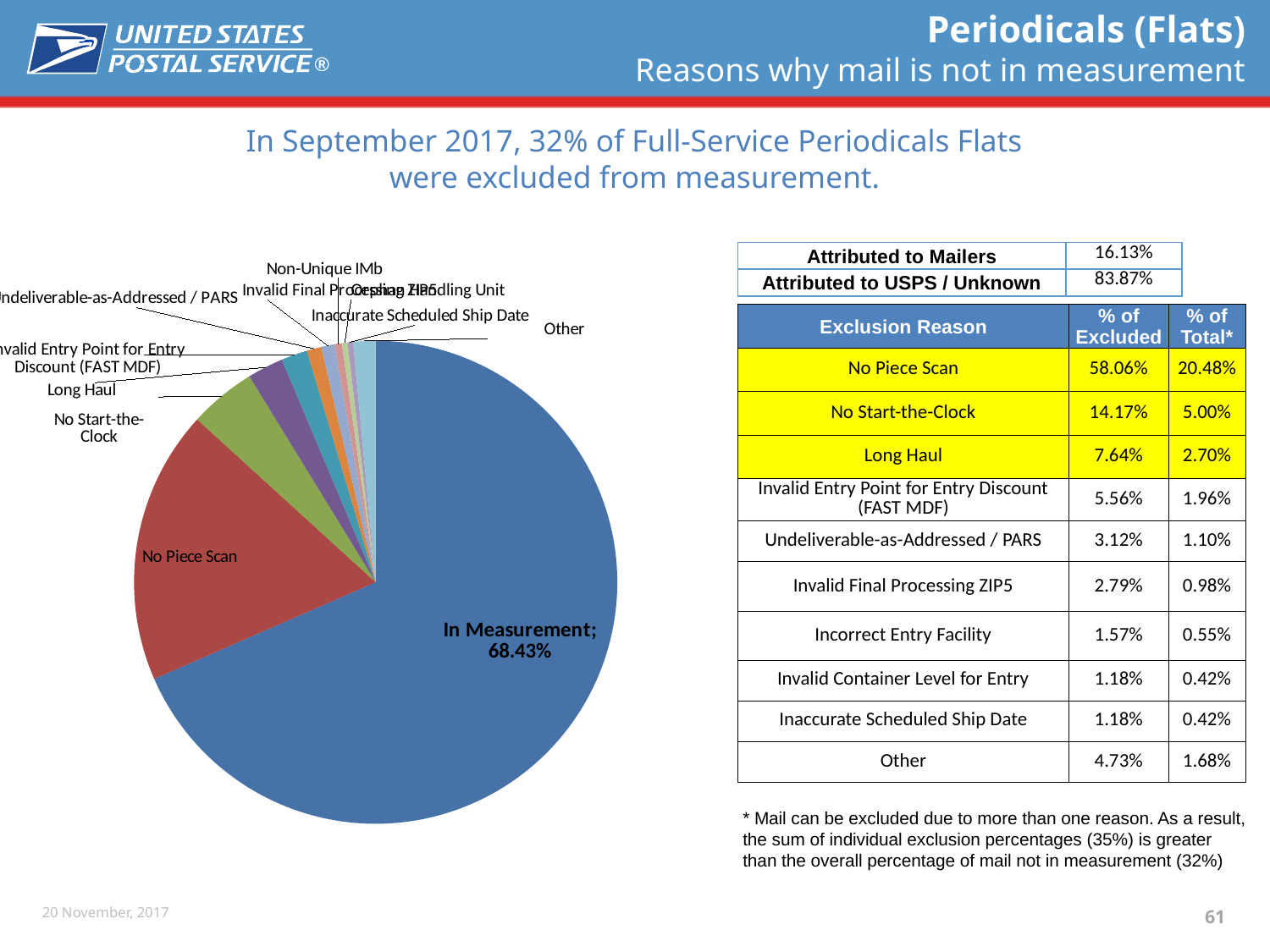
Is the value for In Measurement greater or less than 50%? greater Which slice is larger in the pie chart, Other or No Piece Scan? No Piece Scan Which slice is larger in the pie chart, In Measurement or No Piece Scan? In Measurement Which slice of the pie chart is the largest? In Measurement Which slice is larger in the pie chart, No Piece Scan or Long Haul? No Piece Scan What kind of chart is shown on the slide? pie chart What colour is the No Piece Scan slice of the pie chart? red What percentage of the pie is labelled "In Measurement"? 68.43% What colour is the In Measurement slice of the pie chart? blue